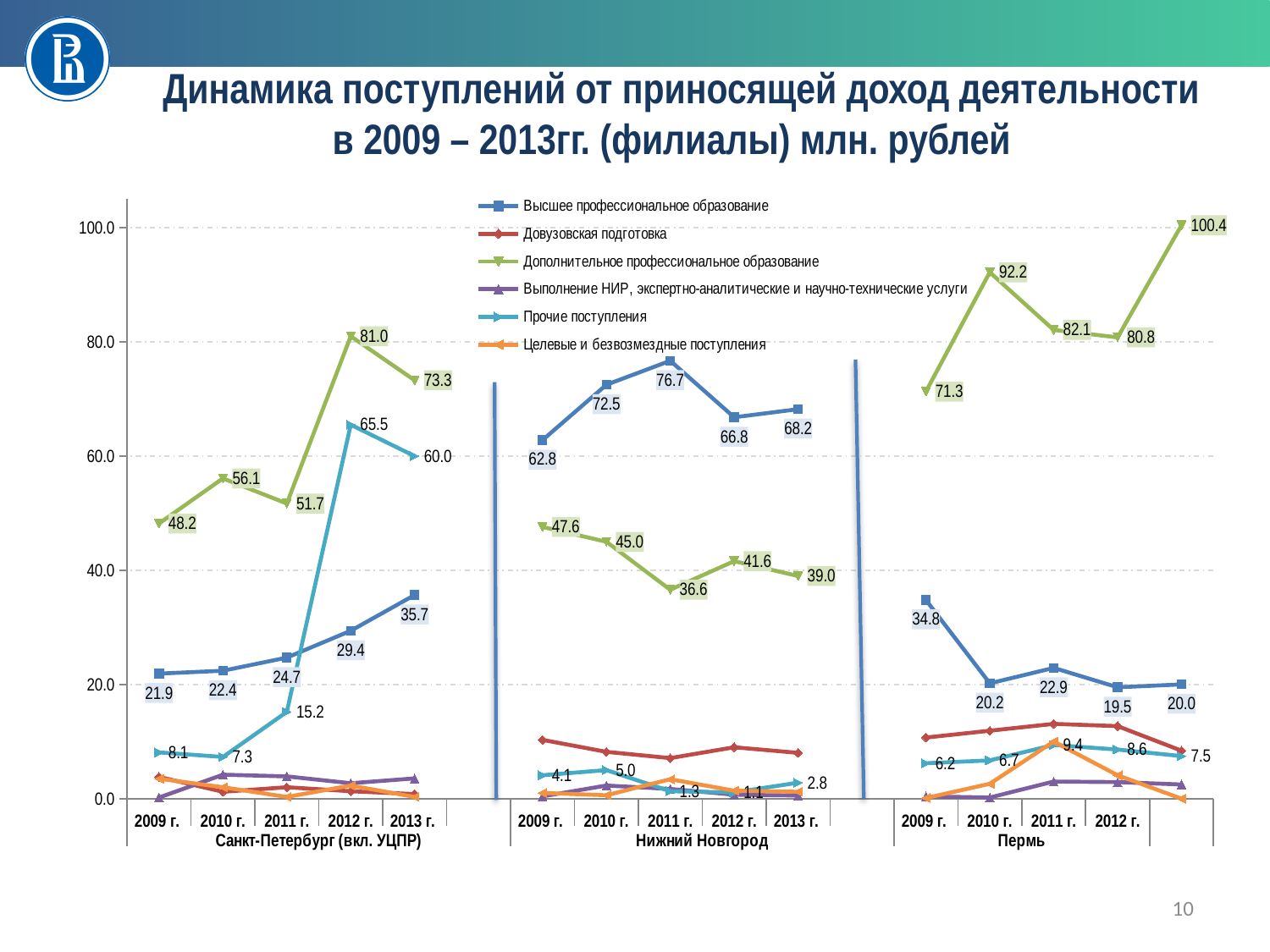
What is the difference between Высшее профессиональное образование for Санкт-Петербург (вкл. УЦПР) in 2013 г. and in 2009 г.? 13.8 Which is larger for Нижний Новгород in 2009 г.: Высшее профессиональное образование or Дополнительное профессиональное образование? Высшее профессиональное образование How many branches (panels) are shown along the x axis of the chart? 3 Is the value of Дополнительное профессиональное образование for Пермь in 2010 г. greater or less than 80? greater How does Высшее профессиональное образование for Санкт-Петербург (вкл. УЦПР) change from 2009 г. to 2013 г.? rises In which year is Высшее профессиональное образование lowest for Пермь? 2012 г. What type of chart is shown on the slide? line chart What is the value of Прочие поступления for Санкт-Петербург (вкл. УЦПР) in 2012 г.? 65.5 What is the value of Высшее профессиональное образование for Нижний Новгород in 2011 г.? 76.7 In which year is Дополнительное профессиональное образование highest for Санкт-Петербург (вкл. УЦПР)? 2012 г. How many series does the legend list? 6